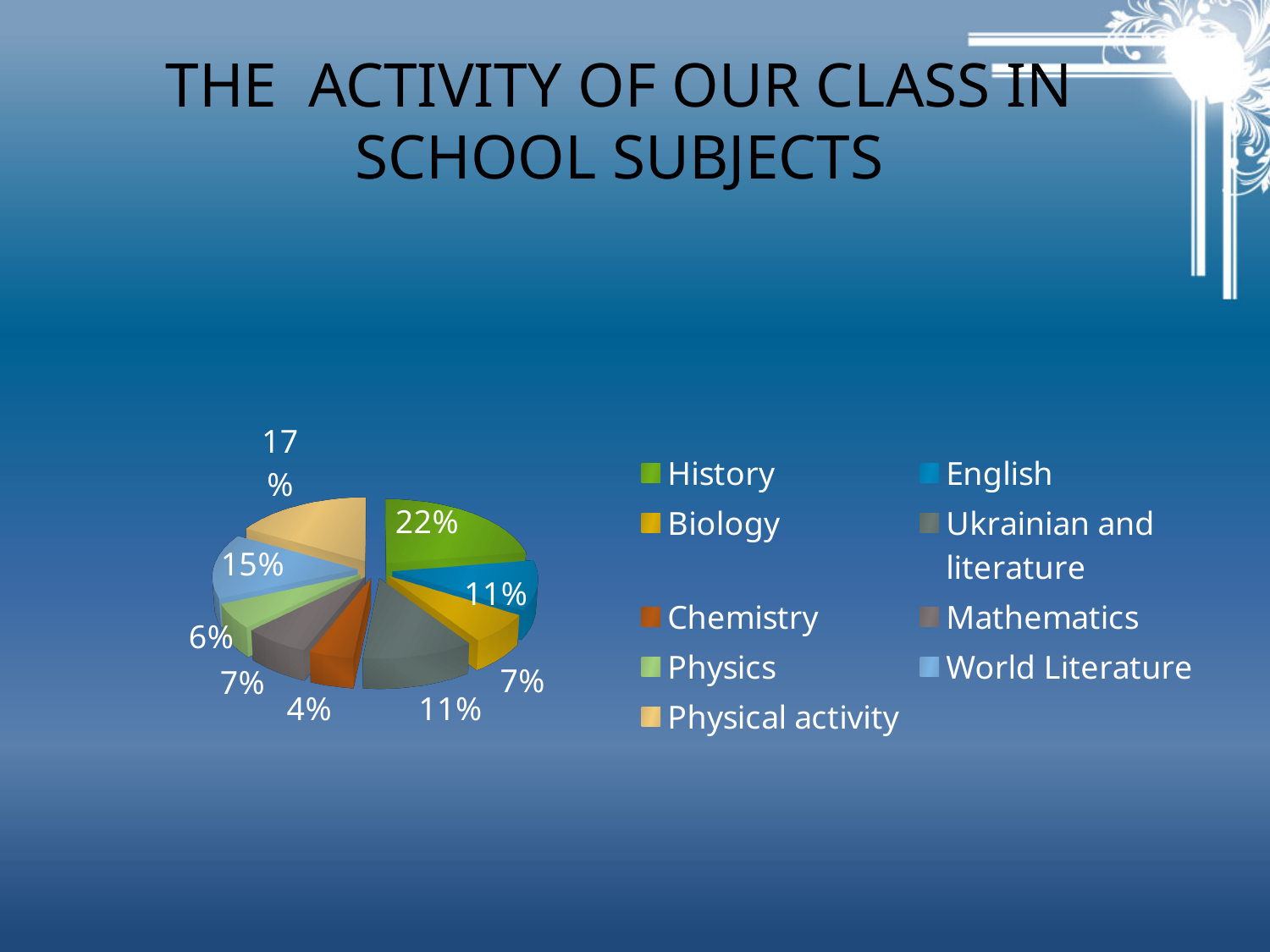
What is the title of the slide? THE ACTIVITY OF OUR CLASS IN SCHOOL SUBJECTS What is the value for World Literature? 15% Which is larger, the slice for World Literature or the slice for English? World Literature Which subject has the largest slice of the pie? History What share of the pie does History have? 22% What percentage is shown for Physical activity? 17% What type of chart is shown on the slide? Pie chart What is the value shown for Physics? 6% Which subject has the smallest slice of the pie? Chemistry How many subjects are shown in the pie chart? 9 What percentage does Chemistry account for? 4% How many percentage points larger is History than Physical activity? 5 percentage points